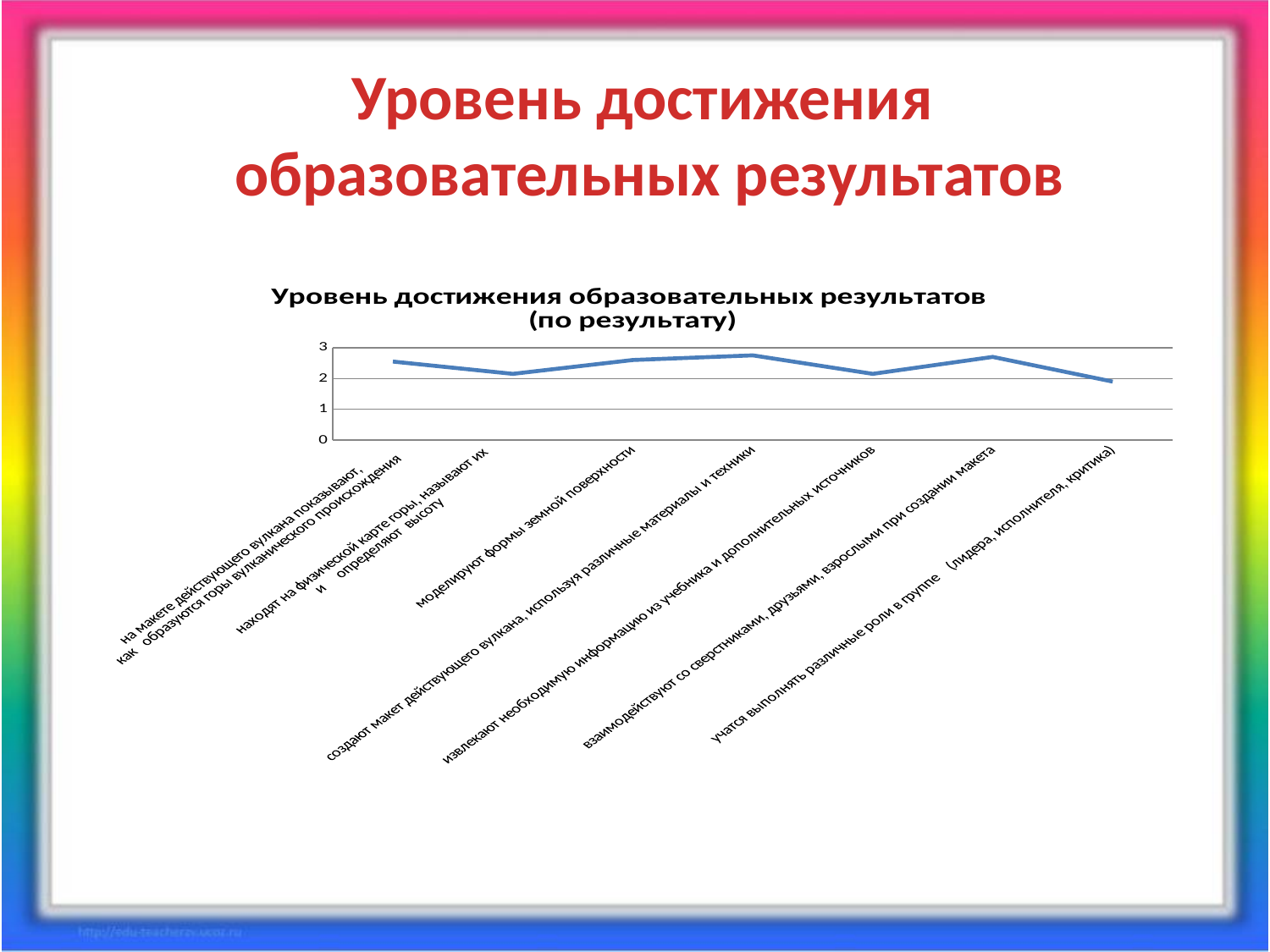
Is the value for "находят на физической карте горы, называют их" greater or less than 1? greater Is the value for "учатся выполнять различные роли в группе" greater or less than 2? less Is the value for "моделируют формы земной поверхности" greater or less than 3? less Which has the larger value: "создают макет действующего вулкана, используя различные материалы и техники" or "извлекают необходимую информацию из учебника и дополнительных источников"? создают макет действующего вулкана, используя различные материалы и техники What is the title of the chart? Уровень достижения образовательных результатов (по результату) Which has the larger value: "на макете действующего вулкана показывают, как образуются горы вулканического происхождения" or "находят на физической карте горы, называют их"? на макете действующего вулкана показывают, как образуются горы вулканического происхождения What kind of chart is shown on the slide? line chart Which category has the lowest value on the chart? учатся выполнять различные роли в группе (лидера, исполнителя, критика) What is the highest value shown on the y axis of the chart? 3 Does the line rise or fall between the sixth category and the last category? fall How many categories are plotted along the x axis of the chart? 7